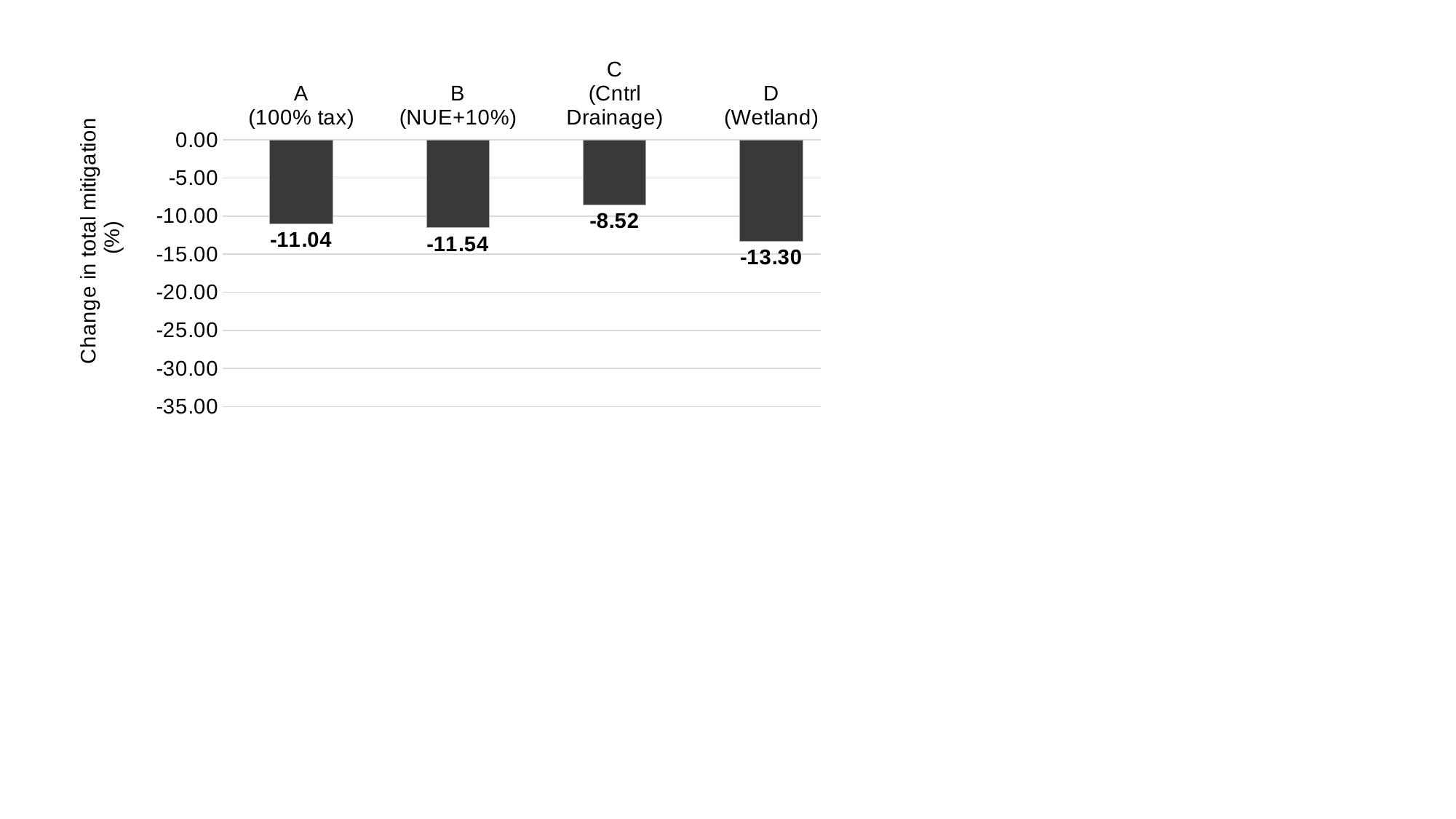
What is the change in total mitigation for A (100% tax)? -11.04 What is the difference between the values for D (Wetland) and C (Cntrl Drainage)? 4.78 What is the difference between the values for B (NUE+10%) and A (100% tax)? 0.50 How many categories are shown in the chart? 4 What is the change in total mitigation for B (NUE+10%)? -11.54 What is the label of the vertical axis? Change in total mitigation (%) What is the change in total mitigation for C (Cntrl Drainage)? -8.52 Which category has the highest (least negative) change in total mitigation? C (Cntrl Drainage) Which has a more negative value, A (100% tax) or D (Wetland)? D (Wetland) Which category has the lowest (most negative) change in total mitigation? D (Wetland) What kind of chart is shown on the slide? Bar chart What is the change in total mitigation for D (Wetland)? -13.30